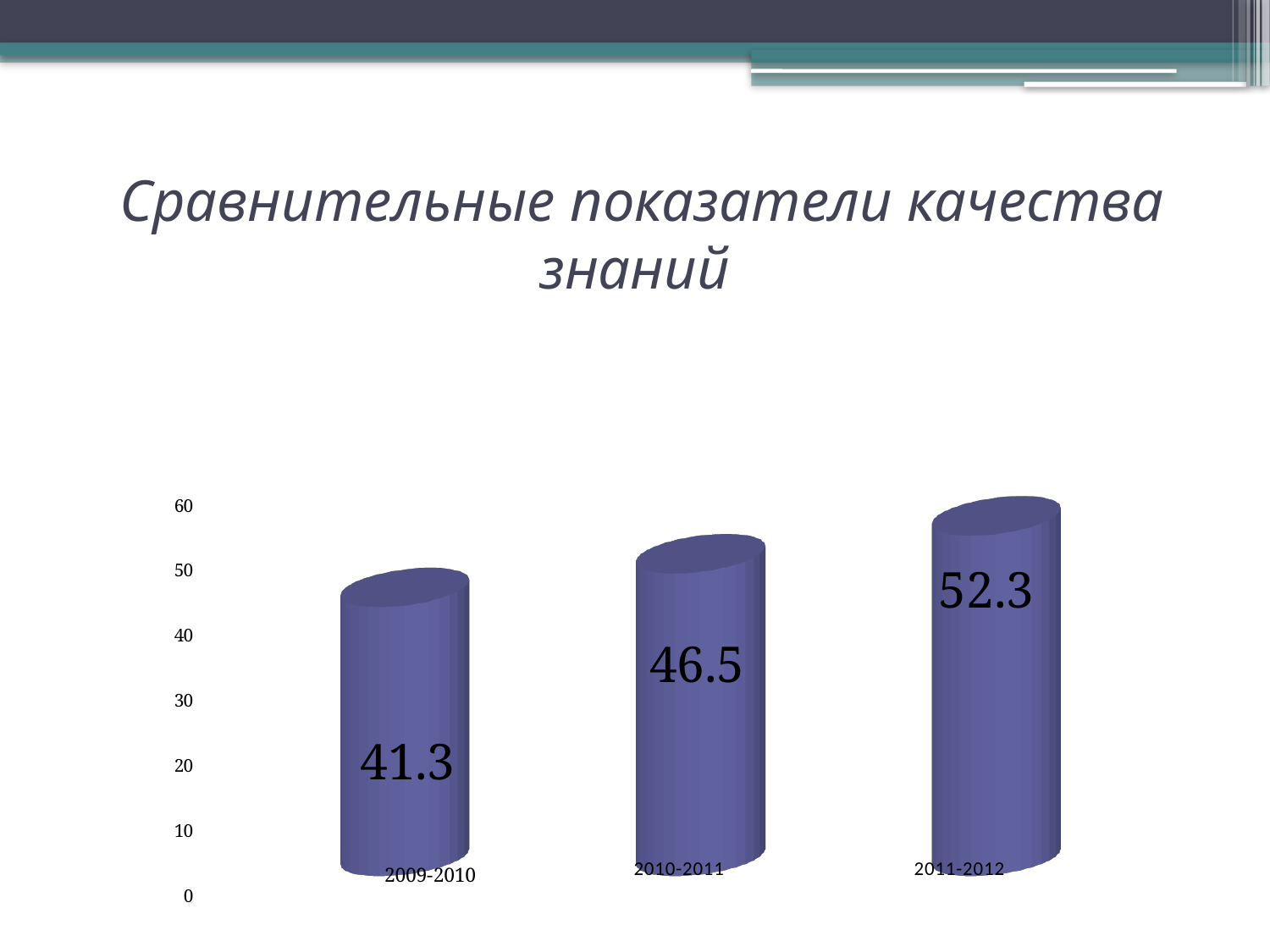
Which year has the lowest value? 2009-2010 What kind of chart is shown on the slide? bar chart Which year has the highest value? 2011-2012 What is the value for 2011-2012? 52.3 What is the value for 2009-2010? 41.3 What is the difference between the values for 2010-2011 and 2009-2010? 5.2 Do the values rise or fall from 2009-2010 to 2011-2012? rise How many categories are shown on the chart? 3 What is the difference between the values for 2011-2012 and 2009-2010? 11.0 What is the value for 2010-2011? 46.5 Which is larger, the value for 2010-2011 or the value for 2011-2012? 2011-2012 Is the value for 2011-2012 greater or less than 50? greater